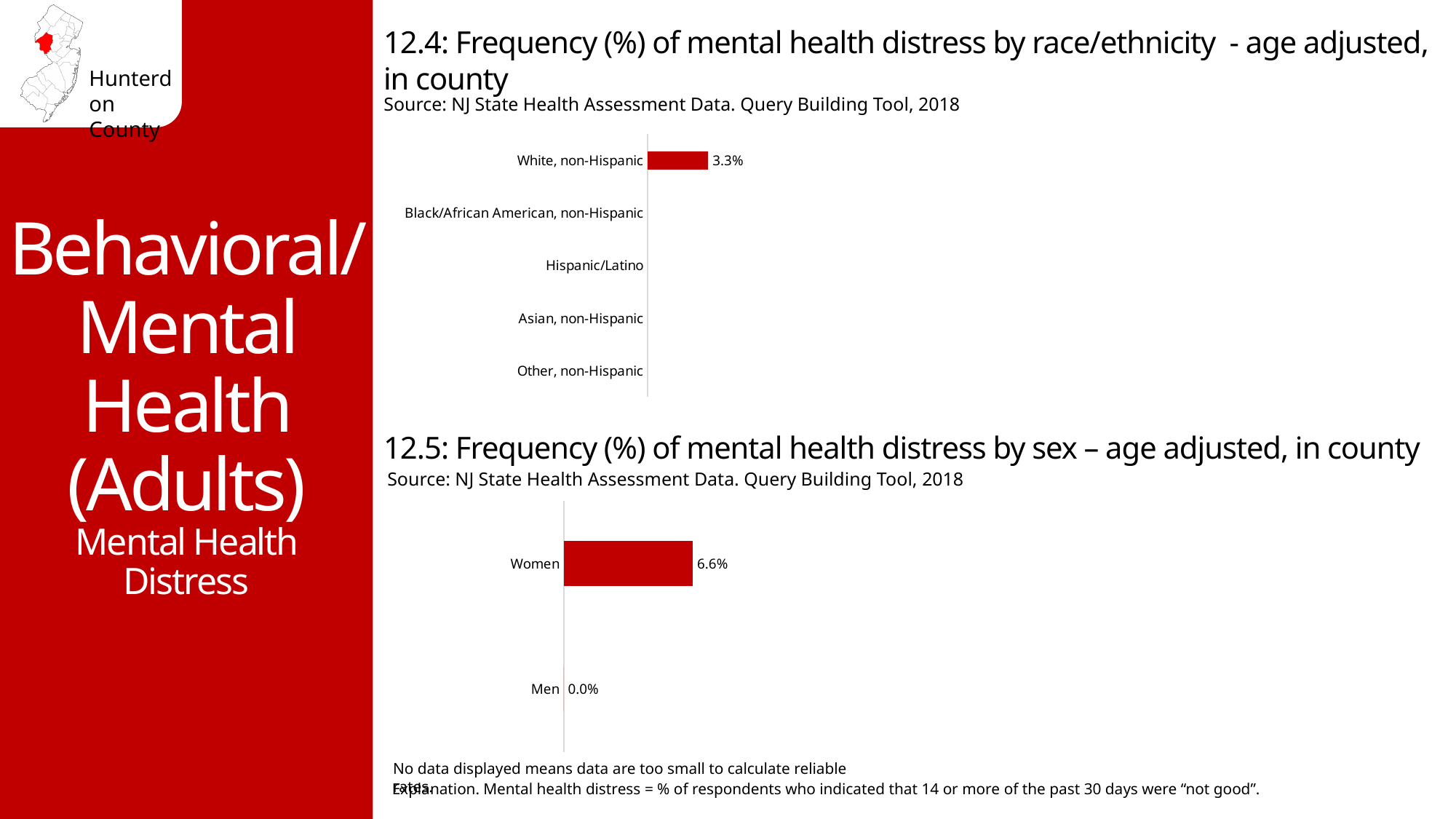
In chart 12.5, what is the difference between the values for Women and Men? 6.6% How many race/ethnicity categories are listed on the axis of chart 12.4? 5 In chart 12.5, which has the larger value, Women or Men? Women In chart 12.5 (mental health distress by sex), which category has the highest value? Women In the chart 12.5 (mental health distress by sex), what is the value for Women? 6.6% What kind of chart is chart 12.5 (mental health distress by sex)? Bar chart In the chart 12.4 (mental health distress by race/ethnicity), what is the value for White, non-Hispanic? 3.3% What kind of chart is chart 12.4 (mental health distress by race/ethnicity)? Bar chart What is the source cited for chart 12.4? NJ State Health Assessment Data. Query Building Tool, 2018 In chart 12.4, which race/ethnicity category is the only one with a bar displayed? White, non-Hispanic How many categories are shown in chart 12.5 (mental health distress by sex)? 2 In the chart 12.5 (mental health distress by sex), what is the value for Men? 0.0%